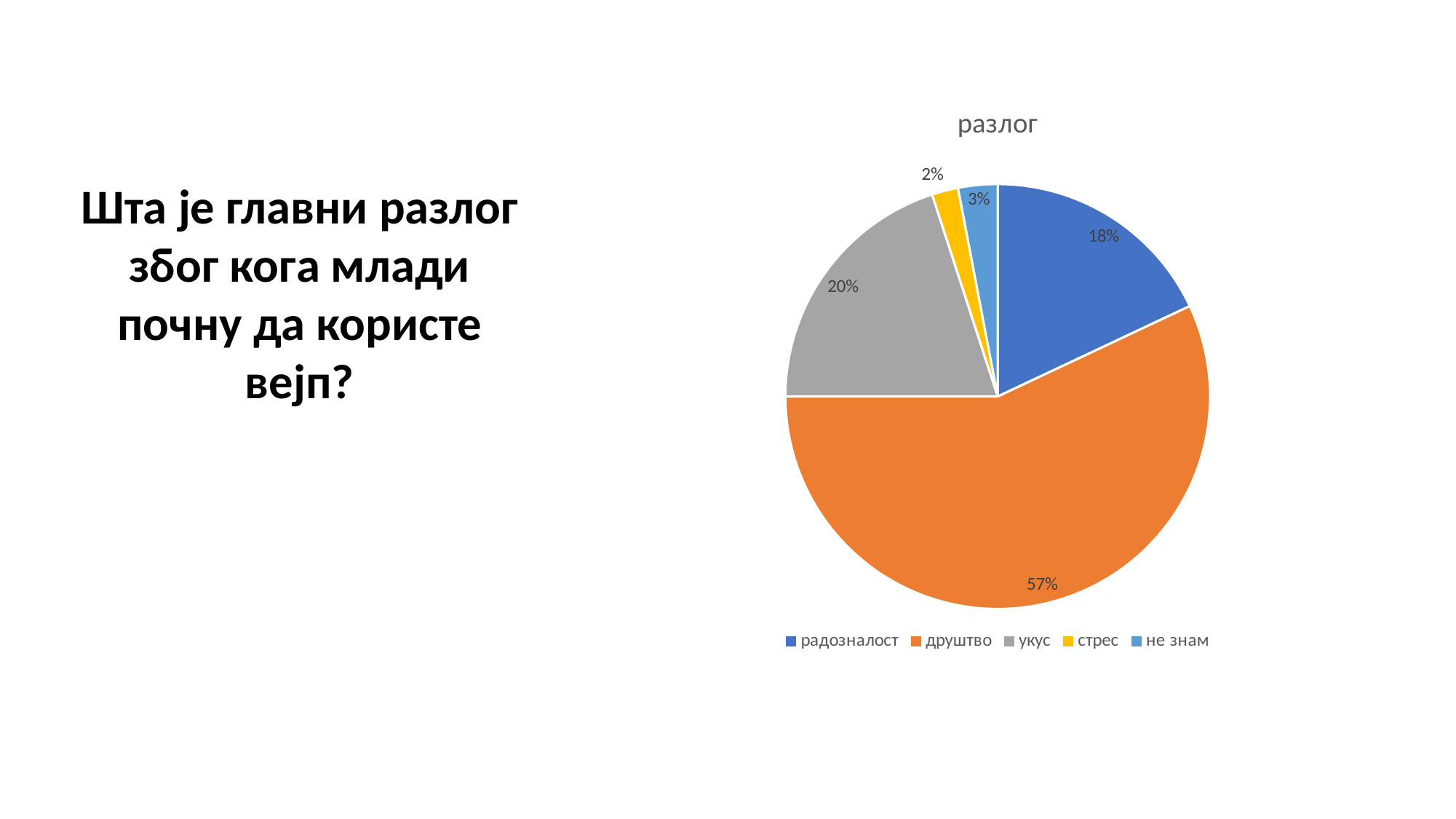
Which category has the largest slice? друштво What is the value for укус? 20% Which category has the smallest slice? стрес What is the value for стрес? 2% What is the difference between the values for друштво and укус? 37% What share of the pie does друштво take? 57% What is the value for радозналост? 18% Which is larger, the value for укус or the value for радозналост? укус What is the title of the chart? разлог What kind of chart is shown on the slide? pie chart What is the value for не знам? 3% How many categories does the legend list? 5